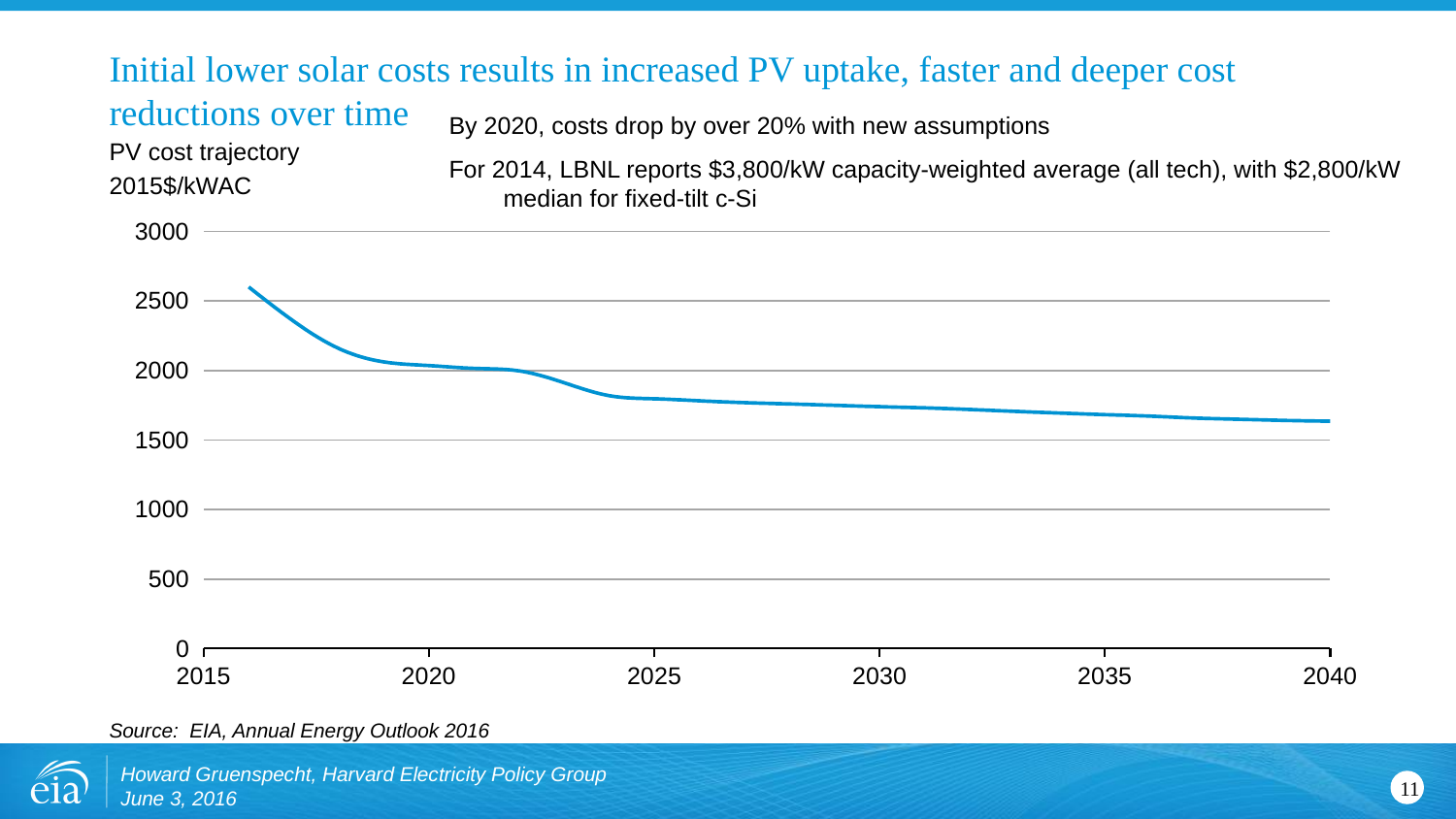
What kind of chart is shown on the slide? line chart Is the PV cost value for 2040 greater or less than 1500? greater Is the PV cost value at the start of the line (around 2016) greater or less than 2500? greater How many year labels are shown on the x axis? 6 What is the highest value shown on the y axis? 3000 Which year has the higher PV cost, 2020 or 2030? 2020 Is the PV cost value for 2040 greater or less than 2000? less How many lines are plotted on the chart? 1 Does the PV cost trajectory rise or fall from 2015 to 2040? fall What unit is the PV cost trajectory measured in, according to the chart subtitle? 2015$/kWAC